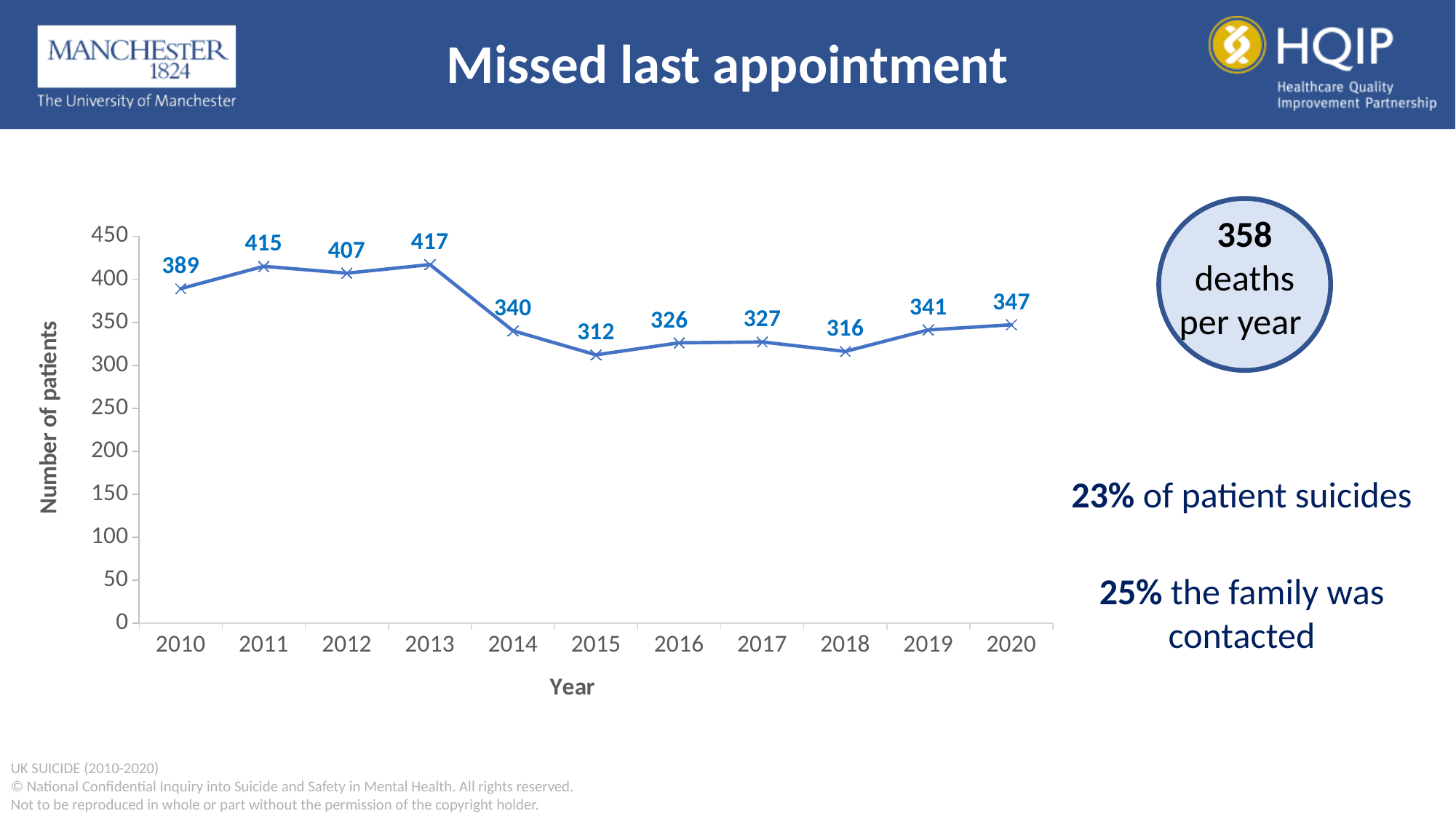
What is the number of patients in 2018? 316 Is the value for 2016 greater or less than 350? less Which year has the lowest number of patients? 2015 What is the difference between the number of patients in 2013 and 2015? 105 What is the number of patients in 2010? 389 What is the number of patients in 2013? 417 How many years are plotted on the chart? 11 What is the difference between the number of patients in 2011 and 2012? 8 What kind of chart is shown on the slide? line chart Which year has more patients, 2014 or 2019? 2019 Which year has the highest number of patients? 2013 What is the label of the y axis? Number of patients